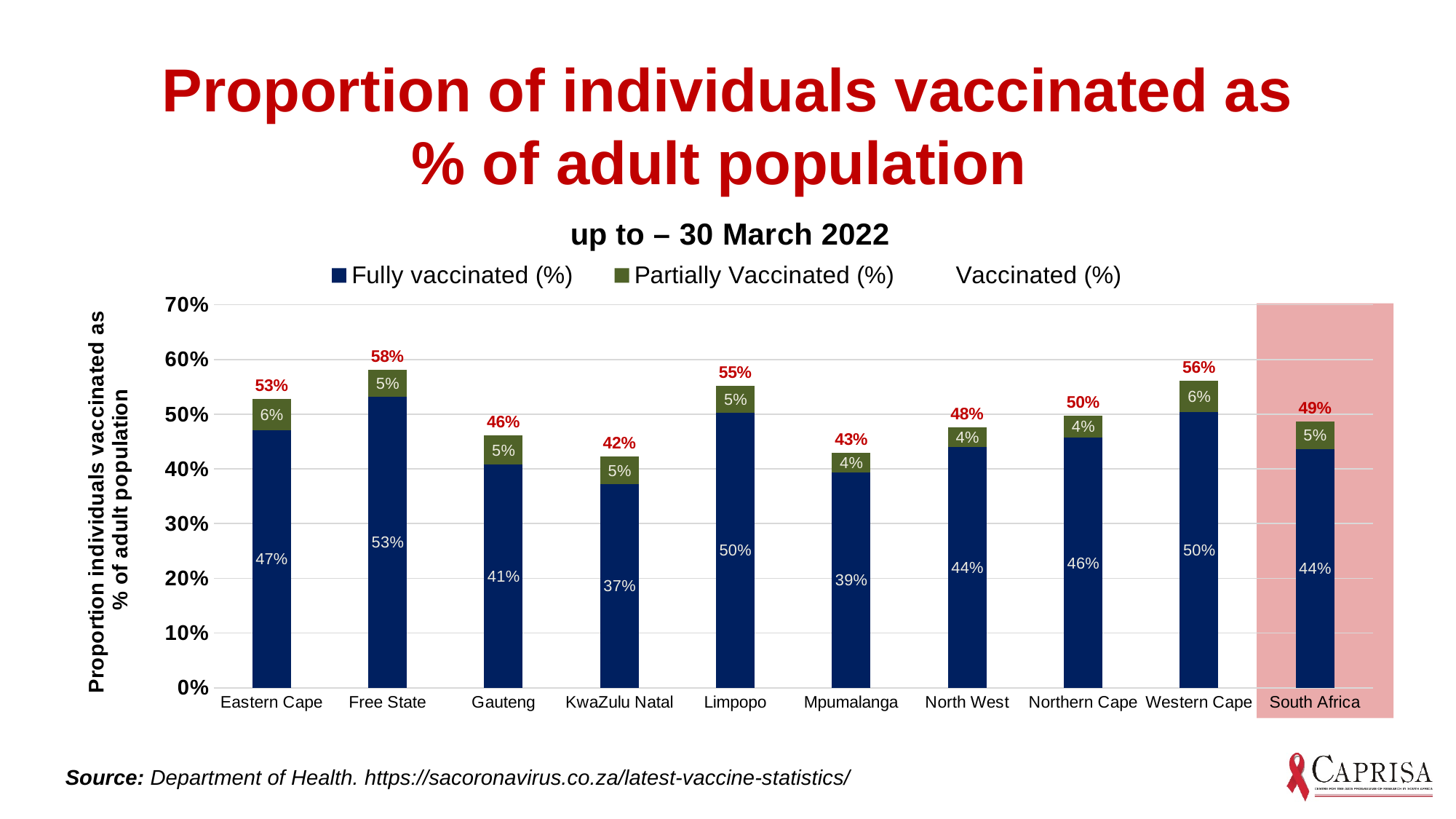
What is the Fully vaccinated (%) value for KwaZulu Natal? 37% What is the total of the stacked bar for Eastern Cape (Fully vaccinated plus Partially Vaccinated)? 53% Which is larger, the total Vaccinated (%) for Limpopo or for Western Cape? Western Cape What is the difference between the Fully vaccinated (%) values for Free State and Gauteng? 12% What is the total Vaccinated (%) value shown above the bar for South Africa? 49% How many series does the legend list? 3 What kind of chart is shown on the slide? Stacked bar chart What is the Partially Vaccinated (%) value for Western Cape? 6% How many categories are shown on the x axis? 10 Which province has the lowest Fully vaccinated (%) value? KwaZulu Natal Which province has the highest total Vaccinated (%)? Free State Is the total Vaccinated (%) for Mpumalanga greater or less than 50%? less